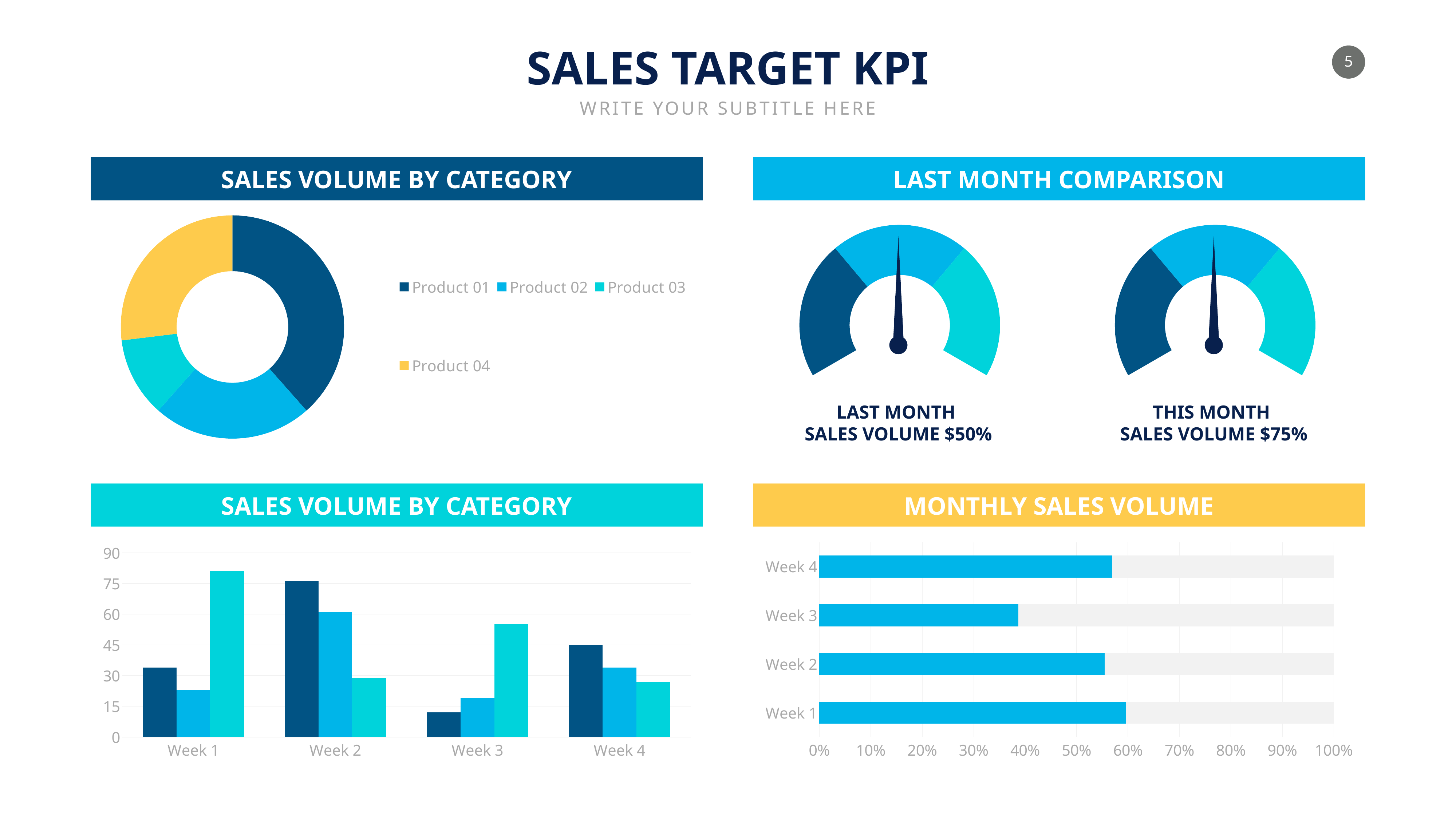
In the 'Monthly Sales Volume' chart, which week has the lowest value? Week 3 How many week categories are on the x axis of the bottom-left bar chart? 4 In the bottom-left bar chart, is the dark blue bar for Week 2 greater or less than 60? greater In the top-left donut chart, which product has the largest slice? Product 01 What kind of chart is shown under the bottom-left 'Sales Volume by Category' heading? Bar chart In the top-left donut chart, which product has the smallest slice? Product 03 In the 'Monthly Sales Volume' chart, is the value for Week 1 greater or less than 50%? greater What kind of chart is shown under the top-left 'Sales Volume by Category' heading? Donut chart How many products does the legend of the top-left donut chart list? 4 In the bottom-left bar chart, is the dark blue bar for Week 3 greater or less than 15? less In the 'Last Month Comparison' section, what is last month's sales volume? $50% In the 'Last Month Comparison' section, what is this month's sales volume? $75%